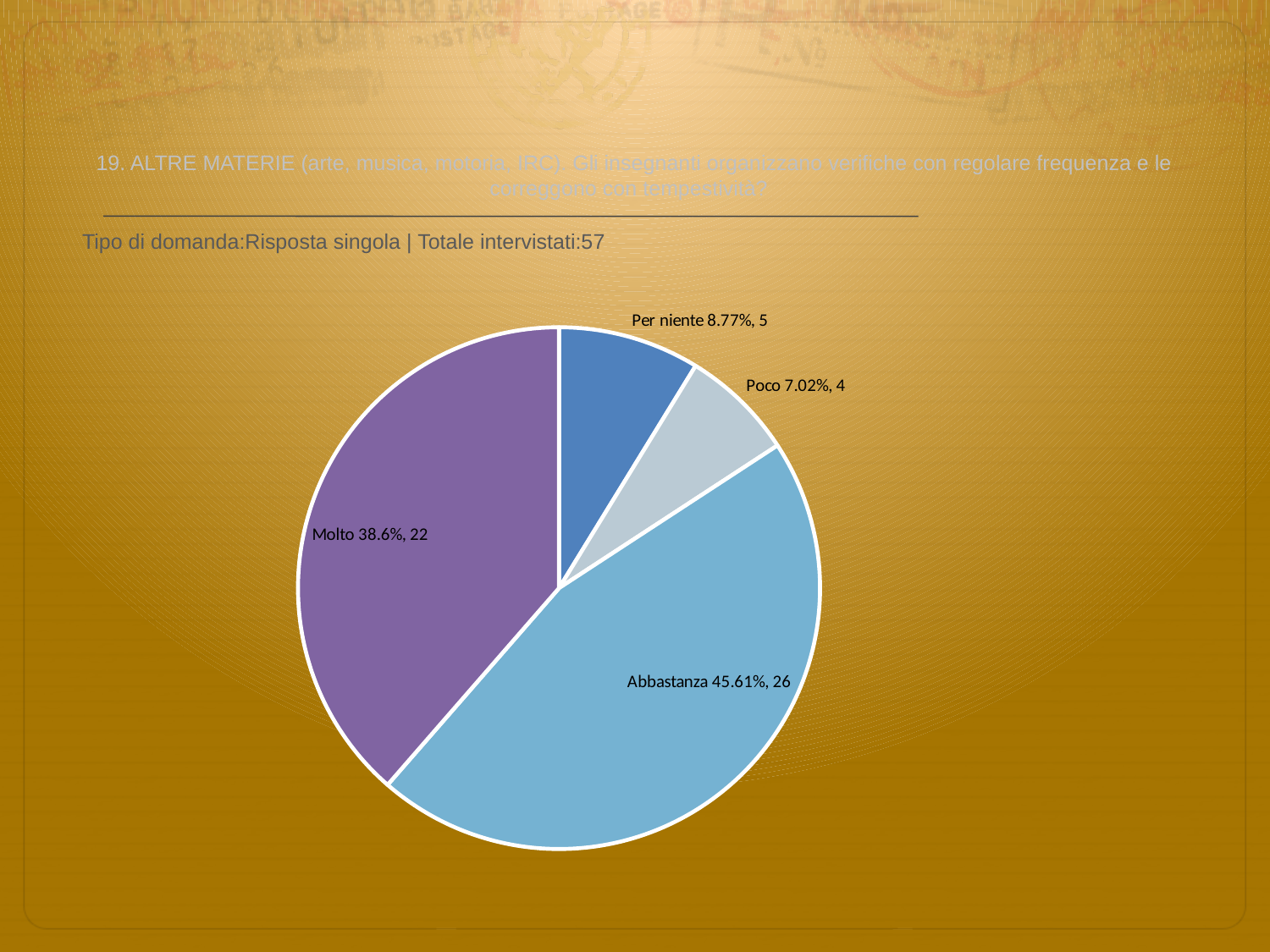
How many respondents answered Molto? 22 What is the percentage share of the Molto slice? 38.6% What kind of chart is shown on the slide? pie chart What is the difference in respondent count between Abbastanza and Molto? 4 What percentage share does the Abbastanza slice have? 45.61% Which category has the smallest slice? Poco What percentage share does the Per niente slice have? 8.77% Which has more respondents, Per niente or Poco? Per niente Which category has the largest slice? Abbastanza How many respondents answered Poco? 4 How many slices does the pie chart have? 4 What is the total number of respondents across all slices? 57